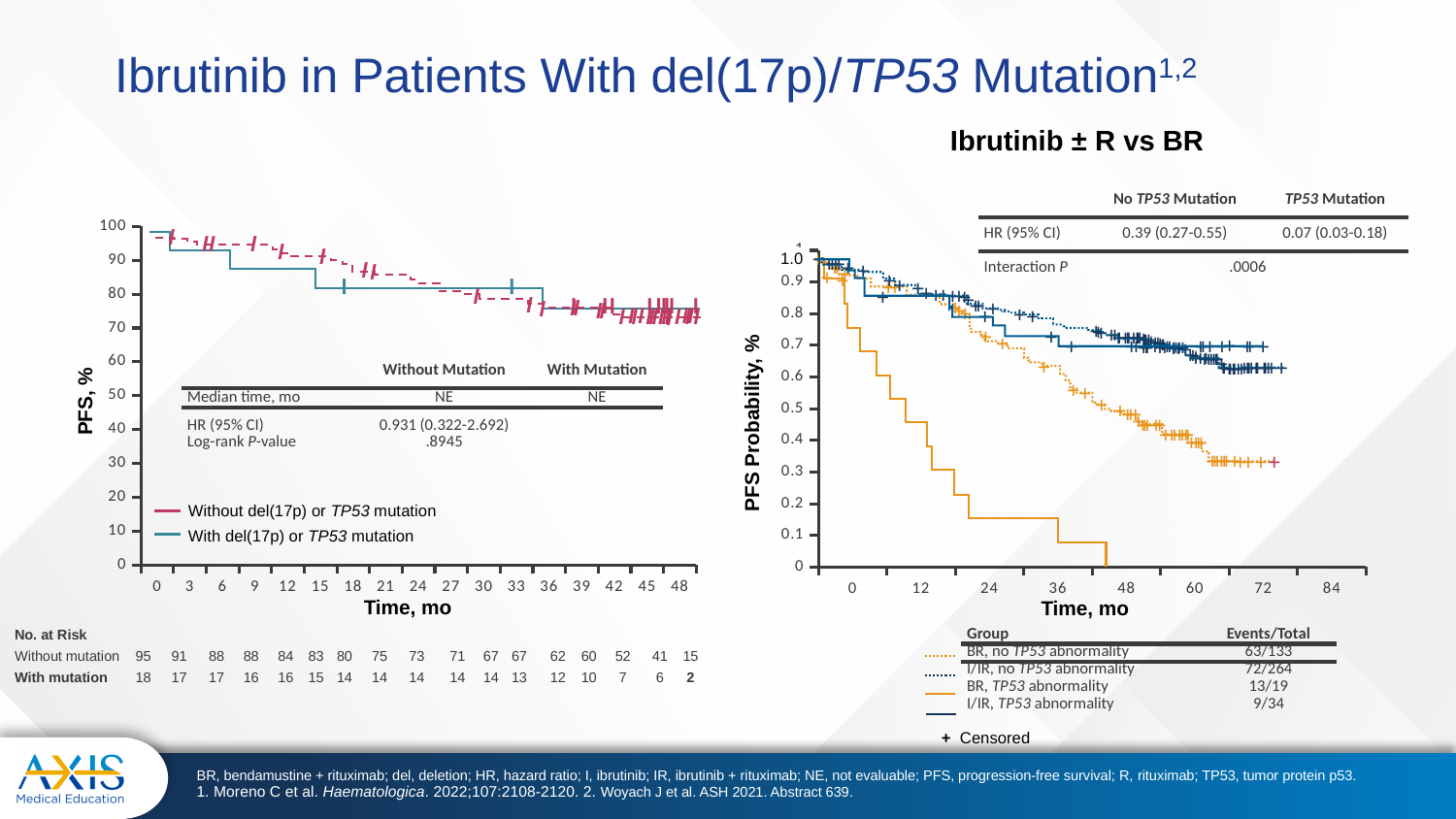
On the right chart, is the PFS probability for the 'BR, TP53 abnormality' group at 24 months greater or less than 0.3? less On the right chart titled 'Ibrutinib ± R vs BR', how many groups does the legend list (excluding the censored marker)? 4 On the left chart, what is the difference between the number at risk for 'Without mutation' and 'With mutation' at time 0? 77 On the left chart, what is the number at risk for the 'Without mutation' group at time 0? 95 On the left chart, what is the number at risk for the 'With mutation' group at 48 months? 2 On the right chart, which group has more events: 'BR, no TP53 abnormality' or 'I/IR, no TP53 abnormality'? I/IR, no TP53 abnormality On the left chart, how many series does the legend list? 2 On the right chart, what is the Events/Total for the 'I/IR, TP53 abnormality' group? 9/34 On the left chart, what is the HR (95% CI) shown in the inset table? 0.931 (0.322-2.692) On the left chart, what kind of chart is shown? Line chart (Kaplan-Meier survival curve) On the left chart, do the PFS curves rise or fall as time increases? Fall On the right chart, what is the HR (95% CI) for patients with TP53 mutation? 0.07 (0.03-0.18)